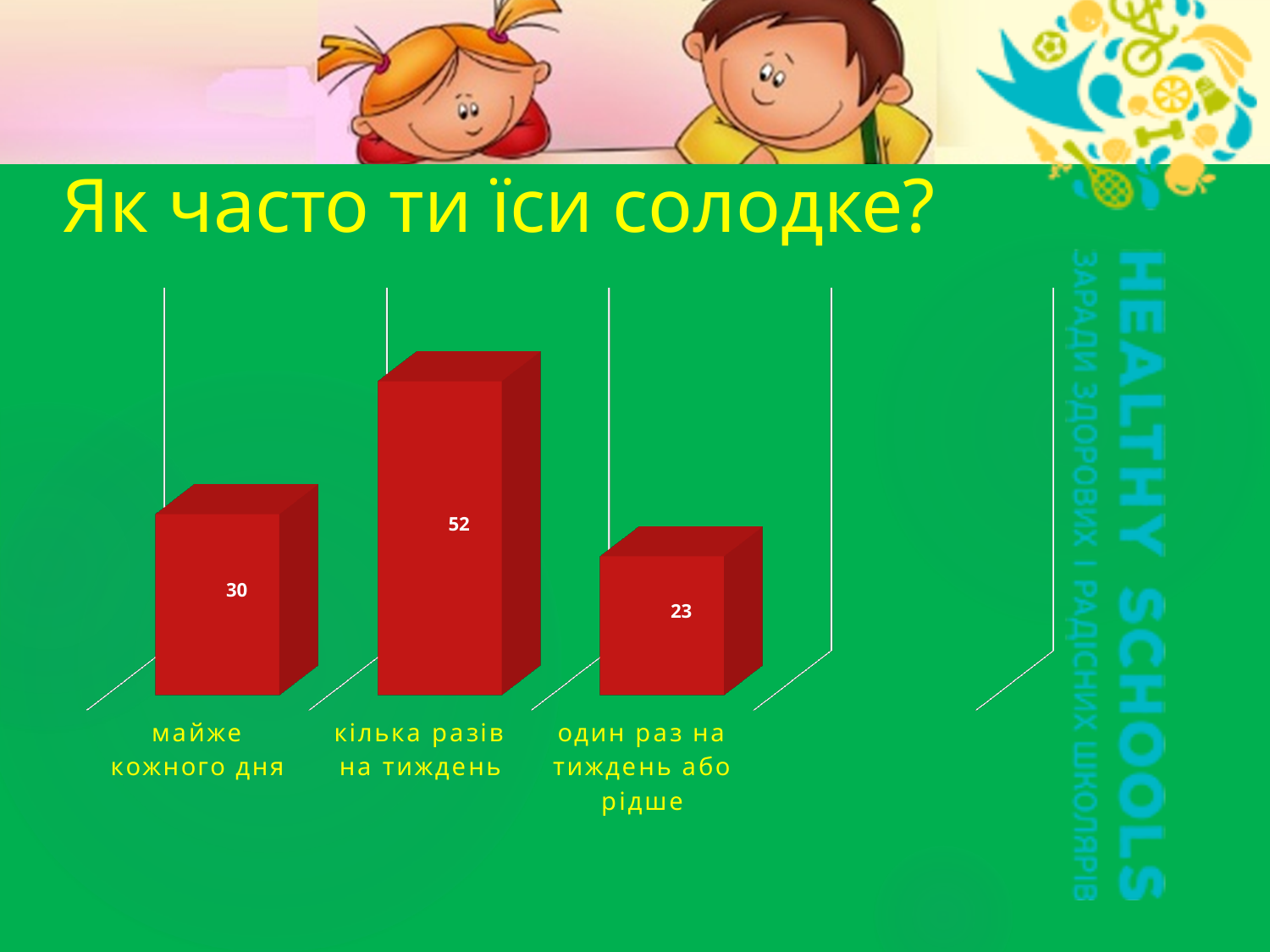
What is the value for "майже кожного дня"? 30 What is the value for "один раз на тиждень або рідше"? 23 What colour are the bars in the chart? red How many categories are shown in the chart? 3 Which category has the highest value? кілька разів на тиждень What is the difference between the values for "кілька разів на тиждень" and "майже кожного дня"? 22 Which category has the lowest value? один раз на тиждень або рідше What is the difference between the values for "майже кожного дня" and "один раз на тиждень або рідше"? 7 What kind of chart is shown on the slide? bar chart What is the value for "кілька разів на тиждень"? 52 Which is larger: the value for "майже кожного дня" or for "один раз на тиждень або рідше"? майже кожного дня What is the title of the slide above the chart? Як часто ти їси солодке?